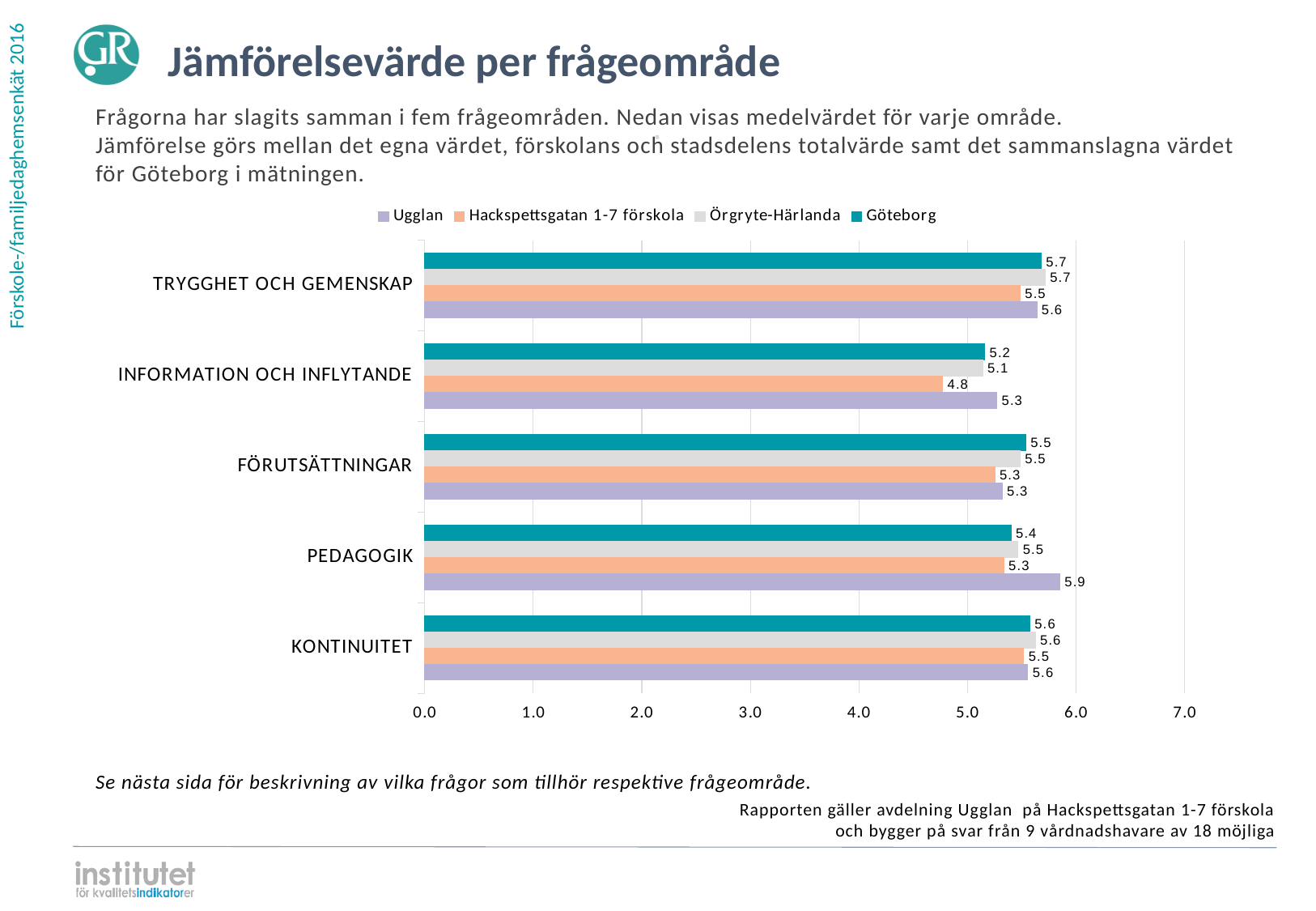
Is the value for Hackspettsgatan 1-7 förskola in the INFORMATION OCH INFLYTANDE category greater or less than 5.0? less What is the value for Hackspettsgatan 1-7 förskola in the INFORMATION OCH INFLYTANDE category? 4.8 What kind of chart is shown on the slide? Bar chart What is the value for Göteborg in the TRYGGHET OCH GEMENSKAP category? 5.7 What is the value for Örgryte-Härlanda in the KONTINUITET category? 5.6 In which category does Ugglan have its highest value? PEDAGOGIK In which category does Hackspettsgatan 1-7 förskola have its lowest value? INFORMATION OCH INFLYTANDE What is the difference between the Ugglan value and the Hackspettsgatan 1-7 förskola value in the PEDAGOGIK category? 0.6 How many categories (frågeområden) are shown on the chart? 5 How many series does the legend list? 4 In the INFORMATION OCH INFLYTANDE category, which is larger: the value for Ugglan or the value for Hackspettsgatan 1-7 förskola? Ugglan What is the value for Ugglan in the PEDAGOGIK category? 5.9